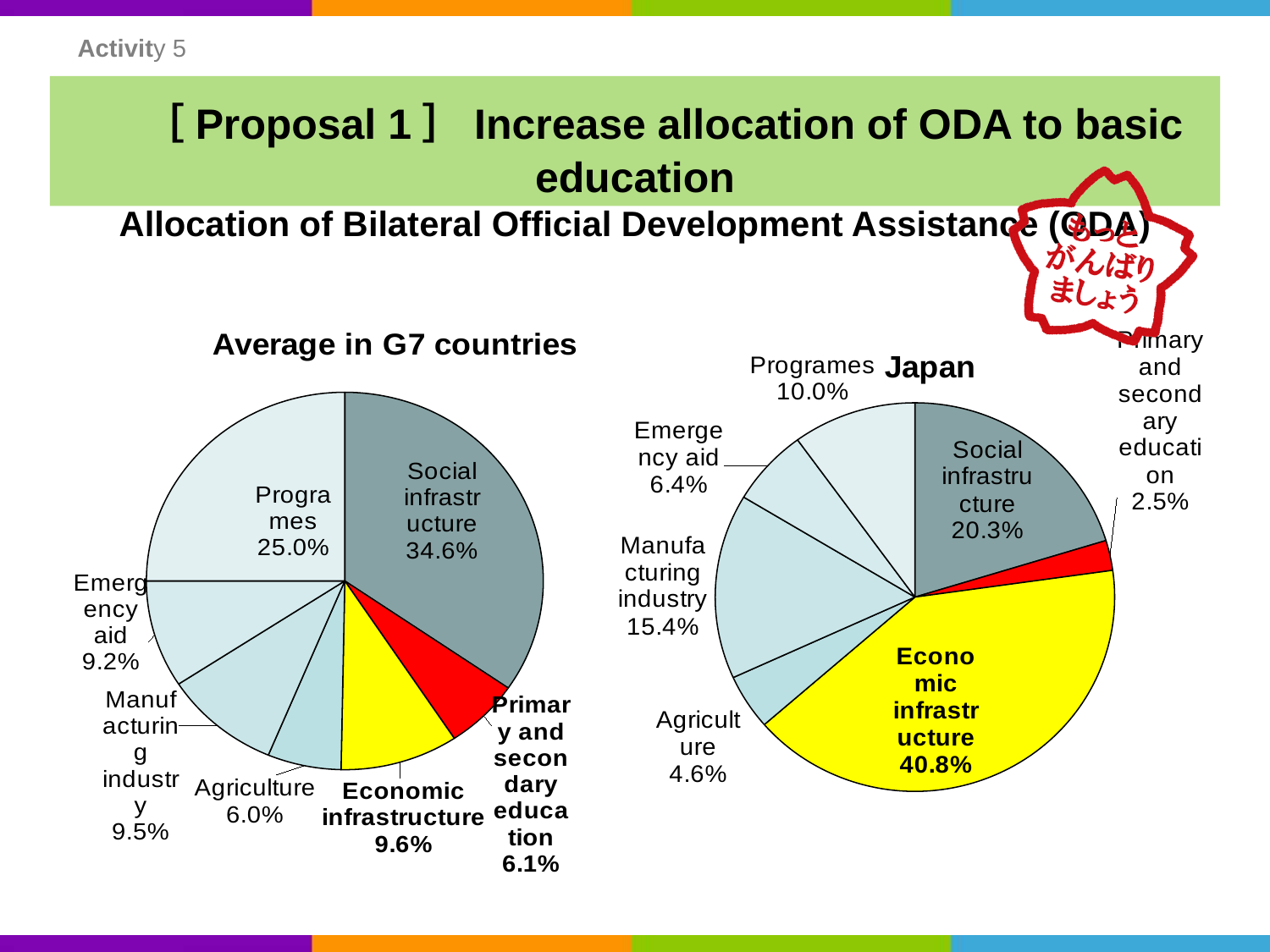
In the 'Japan' chart, what share goes to Primary and secondary education? 2.5% In the 'Average in G7 countries' chart, what share goes to Social infrastructure? 34.6% What kind of chart is the 'Average in G7 countries' chart? pie chart In the 'Average in G7 countries' chart, what share goes to Primary and secondary education? 6.1% In the 'Japan' chart, which category has the largest share? Economic infrastructure In the 'Japan' chart, which category has the smallest share? Primary and secondary education In the 'Average in G7 countries' chart, which category has the smallest share? Agriculture In the 'Japan' chart, what share goes to Economic infrastructure? 40.8% Which is larger: the Manufacturing industry share in the 'Japan' chart or in the 'Average in G7 countries' chart? Japan In the 'Average in G7 countries' chart, which category has the largest share? Social infrastructure How many categories does the 'Japan' pie chart have? 7 In the 'Japan' chart, what is the difference between the Economic infrastructure share and the Social infrastructure share? 20.5%